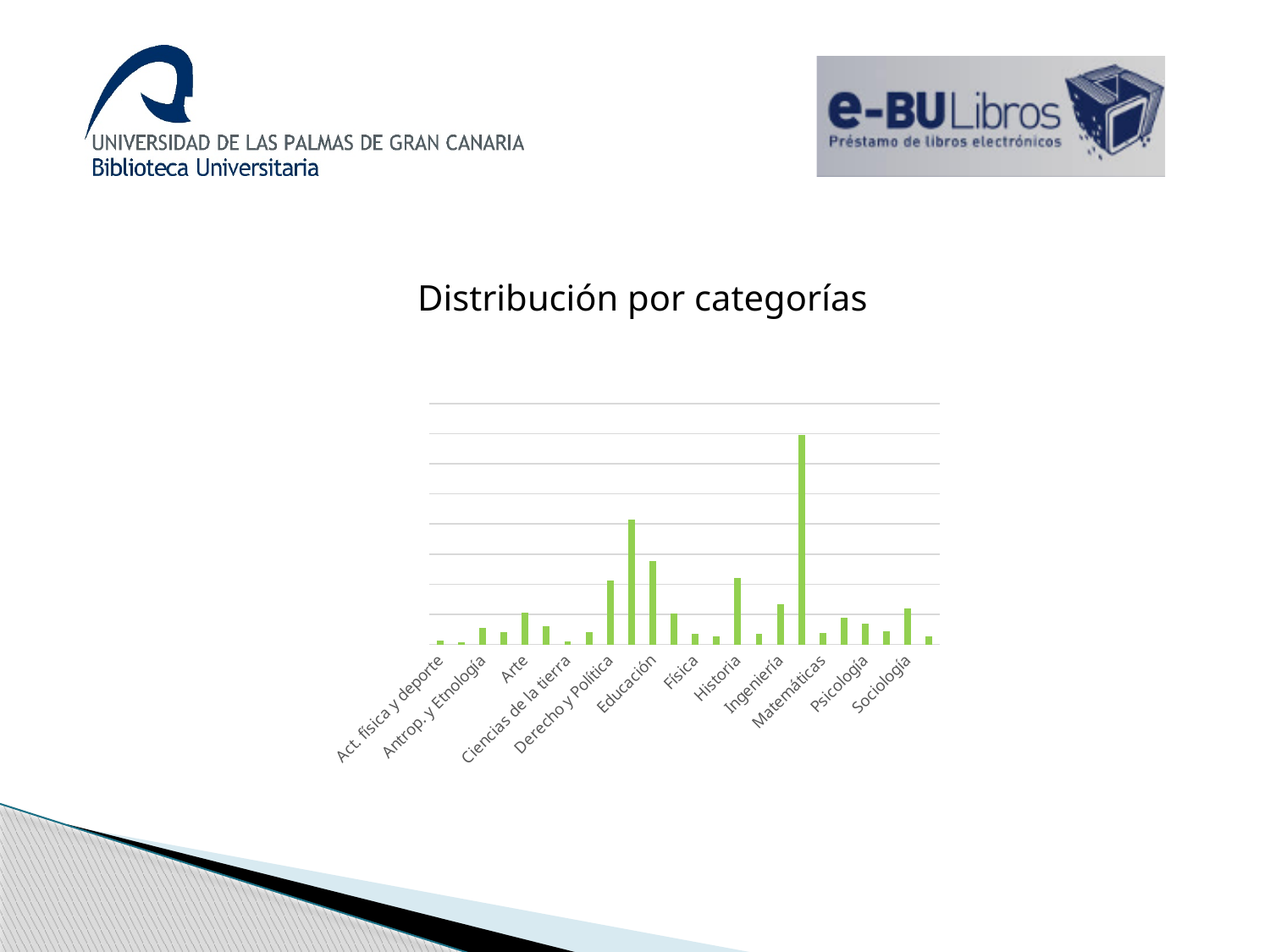
Which has the larger value, Educación or Física? Educación Which has the larger value, Ingeniería or Matemáticas? Ingeniería Which has the larger value, Historia or Sociología? Historia What colour are the bars in the chart? green What is the title of the chart? Distribución por categorías What kind of chart is shown on the slide? bar chart